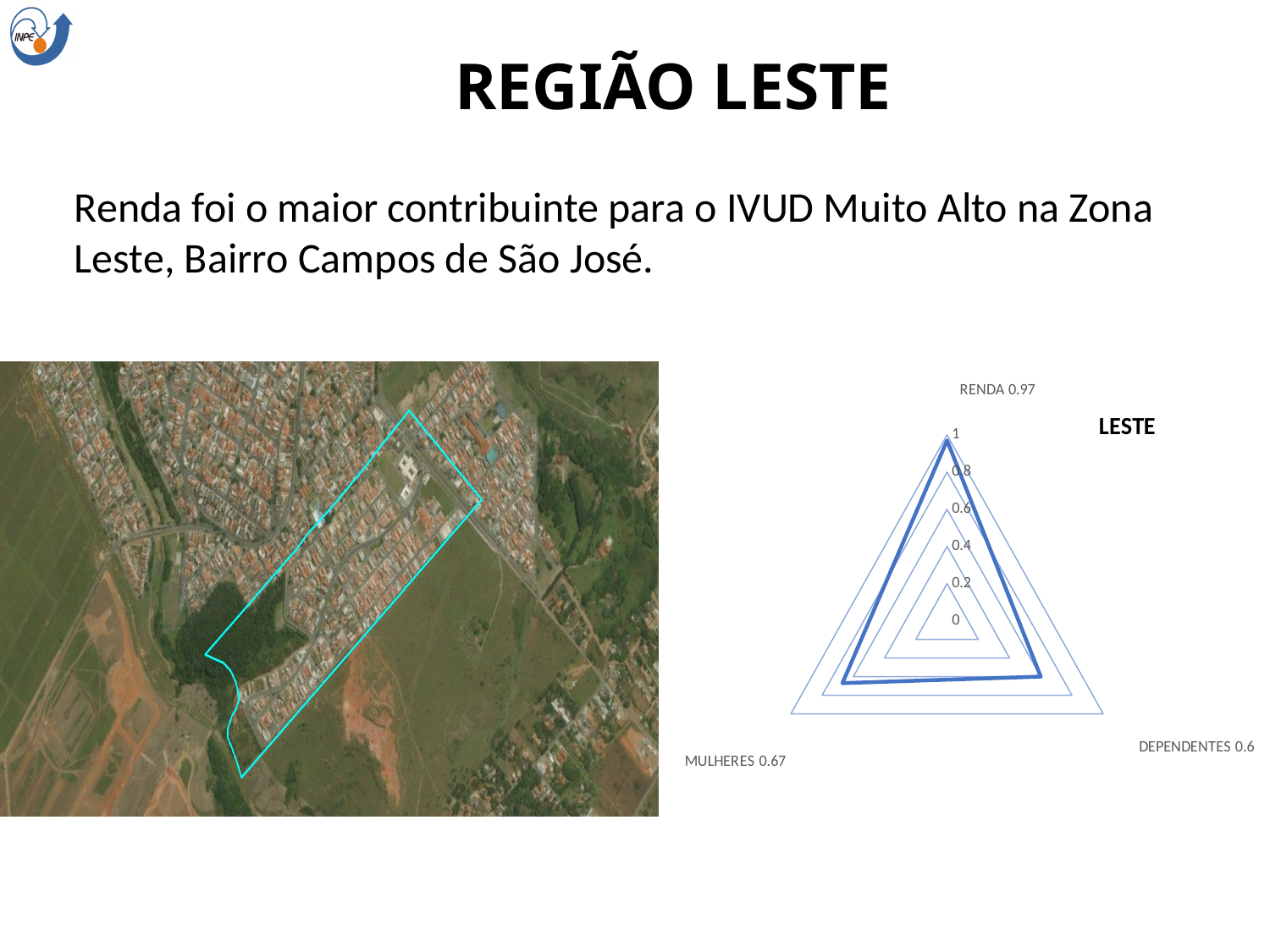
Is the value for RENDA on the LESTE radar chart greater or less than 0.8? greater Which category has the highest value on the LESTE radar chart? RENDA What is the difference between the RENDA and DEPENDENTES values on the LESTE radar chart? 0.37 What is the value for MULHERES on the LESTE radar chart? 0.67 What is the value for RENDA on the LESTE radar chart? 0.97 What is the title of the chart on the right side of the slide? LESTE How many categories (axes) does the LESTE radar chart have? 3 Which category has the lowest value on the LESTE radar chart? DEPENDENTES What kind of chart is shown on the right side of the slide? Radar chart Which is larger on the LESTE radar chart, RENDA or MULHERES? RENDA What is the difference between the MULHERES and DEPENDENTES values on the LESTE radar chart? 0.07 What is the value for DEPENDENTES on the LESTE radar chart? 0.6